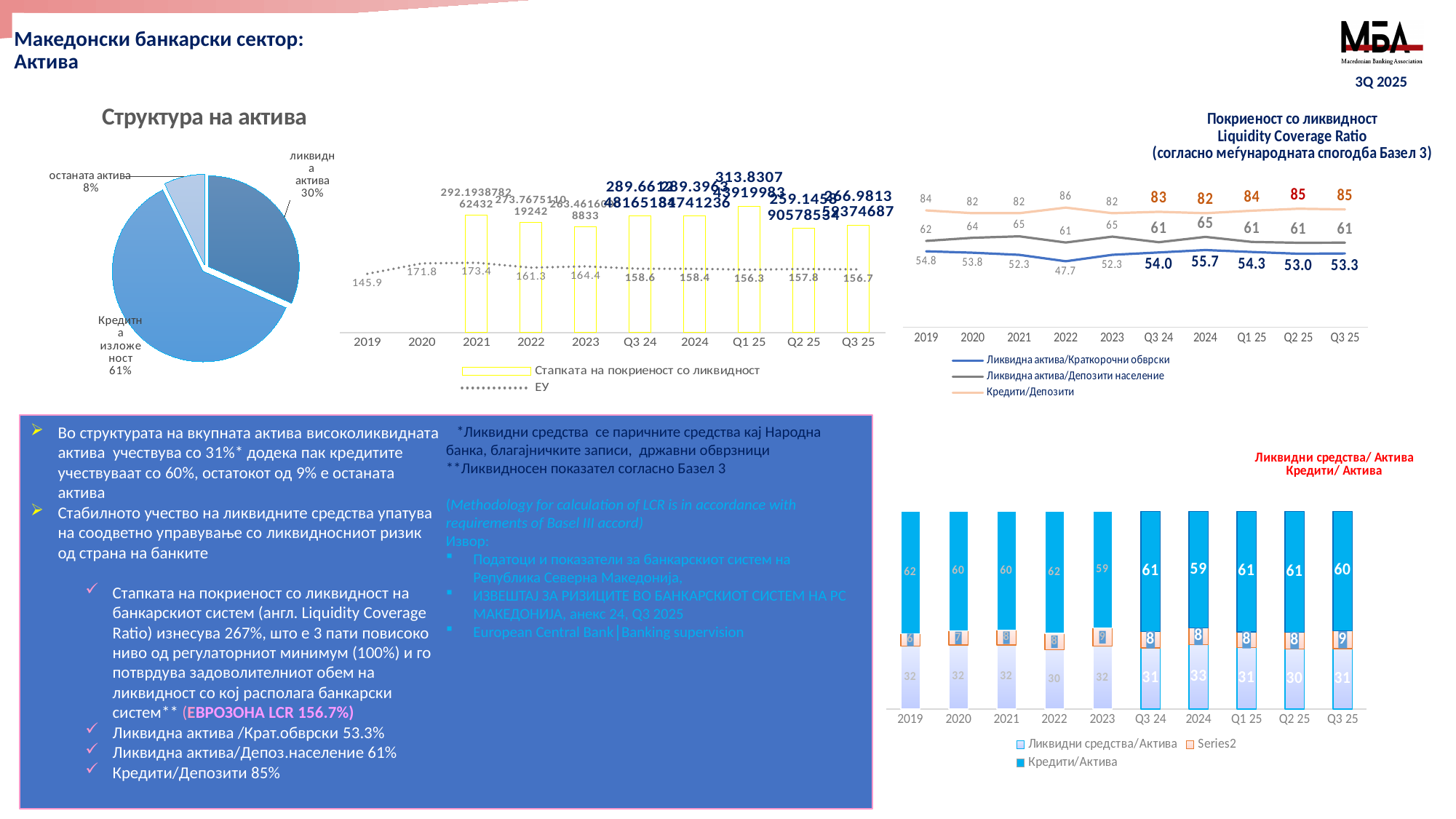
In the bottom-right stacked bar chart, what is the total of the stacked bar for Q3 25? 100 In the 'Покриеност со ликвидност' line chart, what is the difference between 'Кредити/Депозити' and 'Ликвидна актива/Депозити население' for 2024? 17 In the 'Покриеност со ликвидност' line chart, what is the value of 'Ликвидна актива/Краткорочни обврски' for 2022? 47.7 In the middle chart with the 'ЕУ' dotted line, what is the ЕУ value for Q3 25? 156.7 In the pie chart 'Структура на актива', what share is shown for 'Кредитна изложеност'? 61% In the 'Покриеност со ликвидност' line chart, how many series does the legend list? 3 In the middle chart with the 'ЕУ' dotted line, what is the ЕУ value for 2019? 145.9 In the 'Покриеност со ликвидност' line chart, what is the value of 'Кредити/Депозити' for Q3 25? 85 In the middle chart with the 'ЕУ' dotted line, which category has the highest ЕУ value? 2021 In the pie chart 'Структура на актива', what share is shown for 'останата актива'? 8% In the bottom-right stacked bar chart, what is the value of 'Кредити/Актива' for 2023? 59 In the pie chart 'Структура на актива', how many slices are there? 3